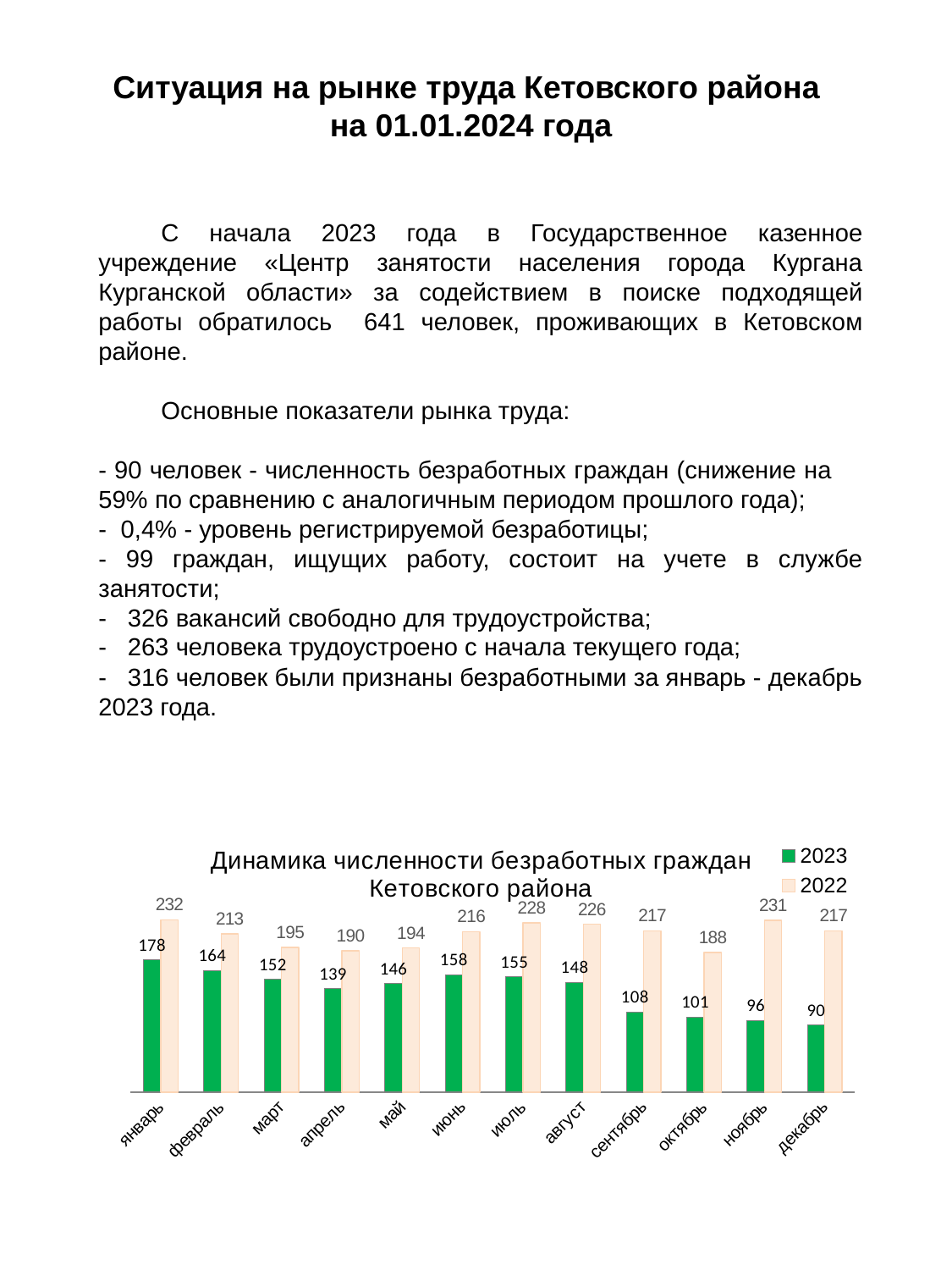
What is the value for 2023 in декабрь? 90 What is the difference between the 2022 and 2023 values in сентябрь? 109 What is the title of the chart? Динамика численности безработных граждан Кетовского района How many months are shown on the x axis? 12 What is the value for 2023 in январь? 178 Does the 2023 series generally rise or fall from январь to декабрь? fall What is the value for 2022 in ноябрь? 231 How many series does the legend list? 2 What kind of chart is shown on the slide? bar chart Which is larger: the 2023 value in июнь or the 2023 value in август? июнь Which month has the lowest value for the 2023 series? декабрь Which month has the highest value for the 2022 series? январь